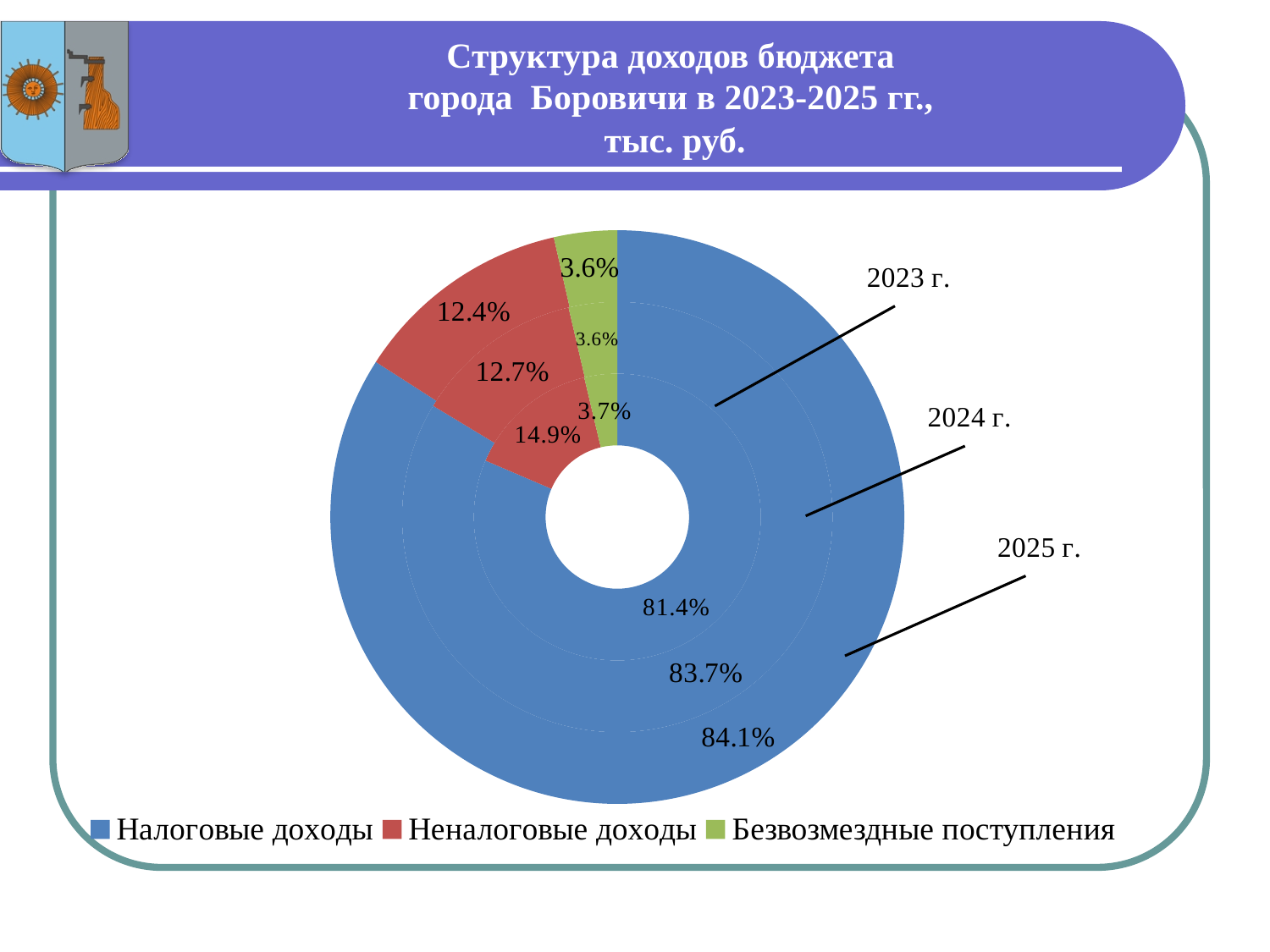
What is the share of Неналоговые доходы in 2024? 12.7% What is the share of Налоговые доходы in 2025? 84.1% What kind of chart is shown on the slide? Doughnut chart Which is larger: the share of Неналоговые доходы in 2023 or in 2025? 2023 How many series does the legend list? 3 Which category has the largest share in 2024? Налоговые доходы What is the share of Налоговые доходы in 2023? 81.4% Which category has the smallest share in 2023? Безвозмездные поступления Does the share of Налоговые доходы rise or fall from 2023 to 2025? Rise What is the share of Безвозмездные поступления in 2025? 3.6% What is the difference between the share of Налоговые доходы in 2025 and in 2023? 2.7% Which colour represents Безвозмездные поступления in the chart? Green